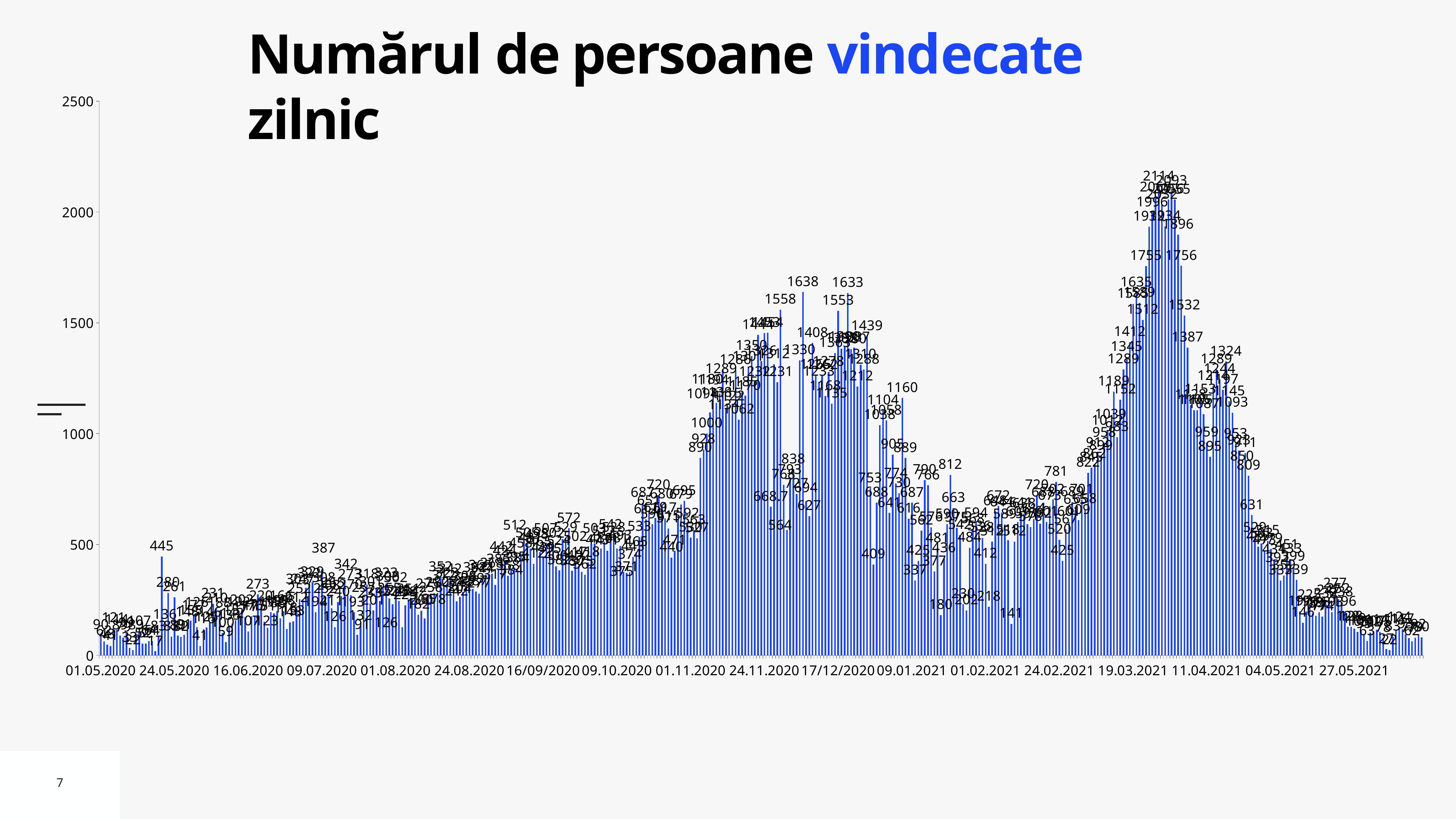
What is the difference between the highest labelled value of the spring 2021 wave (2114) and the highest labelled value of the late-2020 wave (1638)? 476 What kind of chart is shown on the slide? bar chart Do the values rise or fall between 11.04.2021 and 27.05.2021? fall Is the value at 19.03.2021 greater or less than 1000? greater What is the title of the chart? Numărul de persoane vindecate zilnic Is the tallest bar between 24.11.2020 and 17/12/2020 greater or less than 2000? less Is the value at 27.05.2021 greater or less than 500? less What is the highest value labelled on the chart? 2114 What is the highest value labelled in the first wave, between 01.05.2020 and 16.06.2020? 445 Which peak is higher: the one between 19.03.2021 and 11.04.2021, or the one between 24.11.2020 and 17/12/2020? the one between 19.03.2021 and 11.04.2021 What is the highest tick shown on the vertical axis? 2500